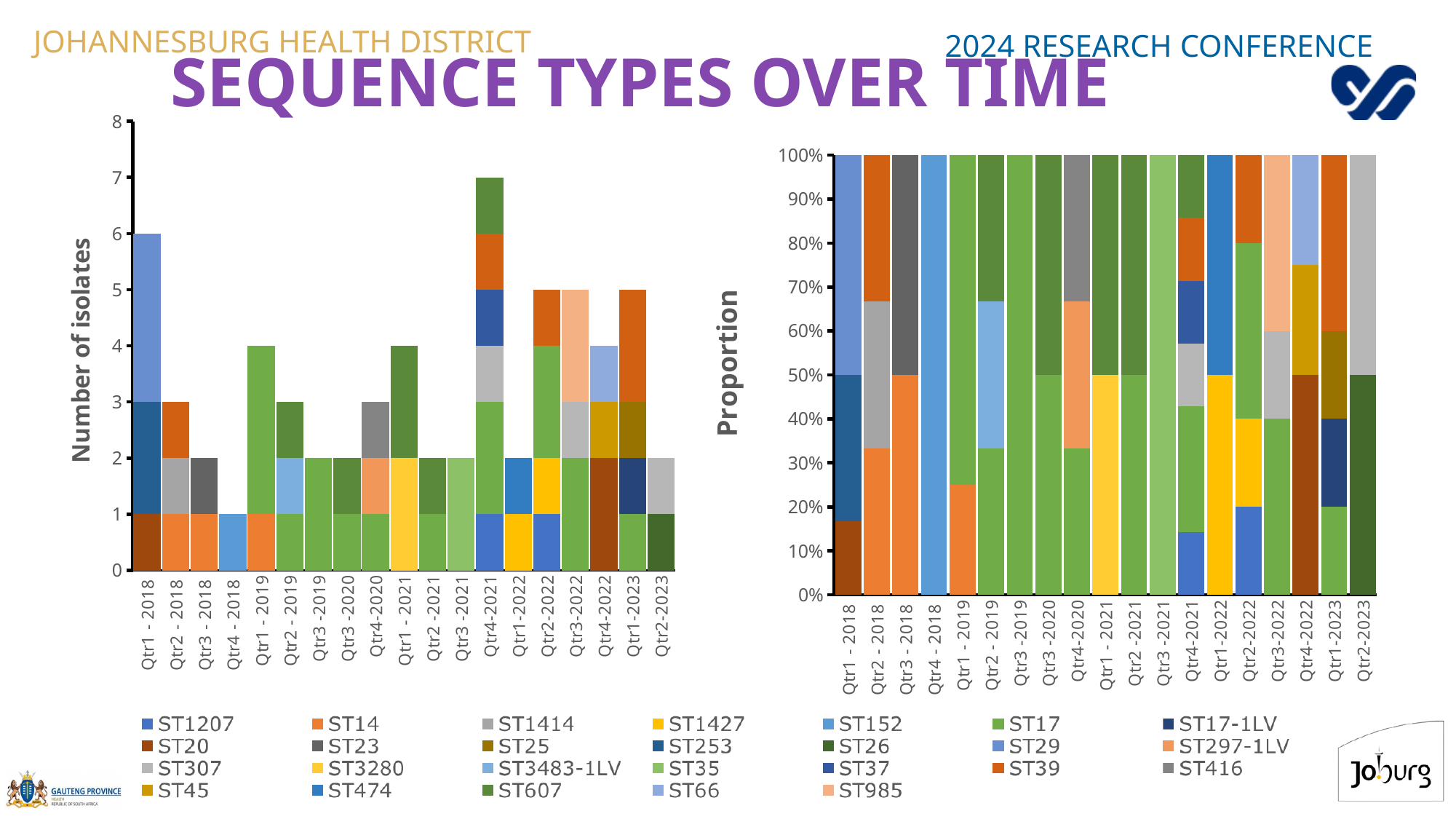
What is the y-axis title of the right chart? Proportion In the left chart (Number of isolates), which quarter has the highest total number of isolates? Qtr4-2021 In the right chart (Proportion), is the bottom segment of the Qtr1 - 2018 bar greater or less than 20%? less In the left chart (Number of isolates), what is the total number of isolates for Qtr1 - 2018? 6 In the left chart (Number of isolates), what is the total number of isolates for Qtr4-2021? 7 How many sequence types does the legend list? 26 What kind of chart is the left chart, titled 'Number of isolates'? Stacked bar chart In the left chart (Number of isolates), which quarter has the lowest total number of isolates? Qtr4 - 2018 In the left chart (Number of isolates), what is the difference between the total for Qtr4-2021 and the total for Qtr4 - 2018? 6 In the left chart (Number of isolates), is the total for Qtr1 - 2018 greater or less than 5? greater How many quarter categories are shown on the x axis of the left chart (Number of isolates)? 19 In the left chart (Number of isolates), which quarter has a larger total: Qtr1 - 2018 or Qtr2 - 2018? Qtr1 - 2018